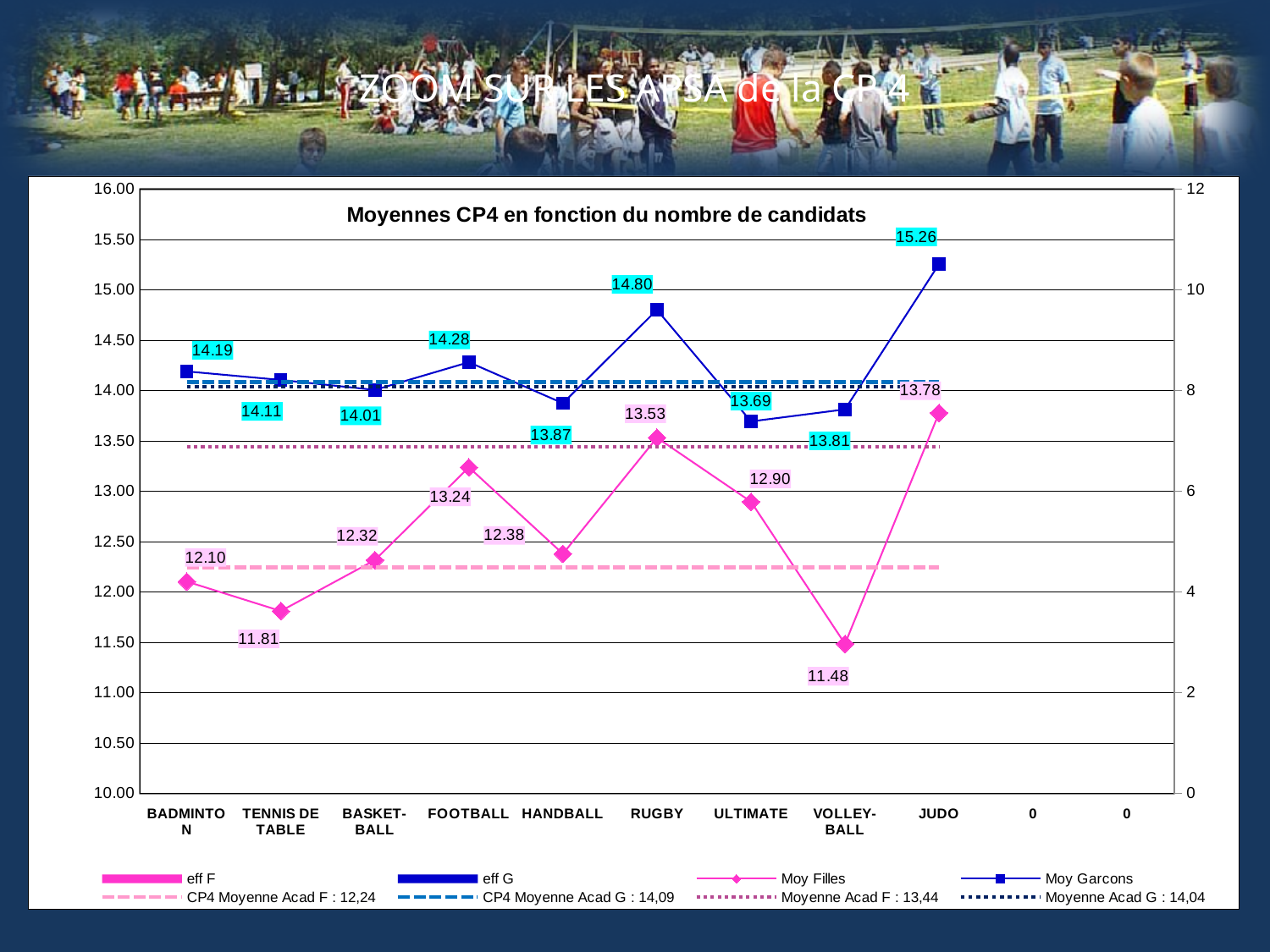
What is the Moy Garcons value for JUDO? 15.26 Which is larger, the Moy Filles value for FOOTBALL or for RUGBY? RUGBY What is the Moy Filles value for BADMINTON? 12.10 What is the Moy Filles value for VOLLEY-BALL? 11.48 How many entries does the legend list? 8 Which category has the lowest Moy Filles value? VOLLEY-BALL What is the difference between the Moy Garcons and Moy Filles values for RUGBY? 1.27 Which category has the highest Moy Garcons value? JUDO What is the Moy Garcons value for HANDBALL? 13.87 What is the title of the chart? Moyennes CP4 en fonction du nombre de candidats What is the difference between the Moy Garcons values for JUDO and BADMINTON? 1.07 Which category has the lowest Moy Garcons value? ULTIMATE